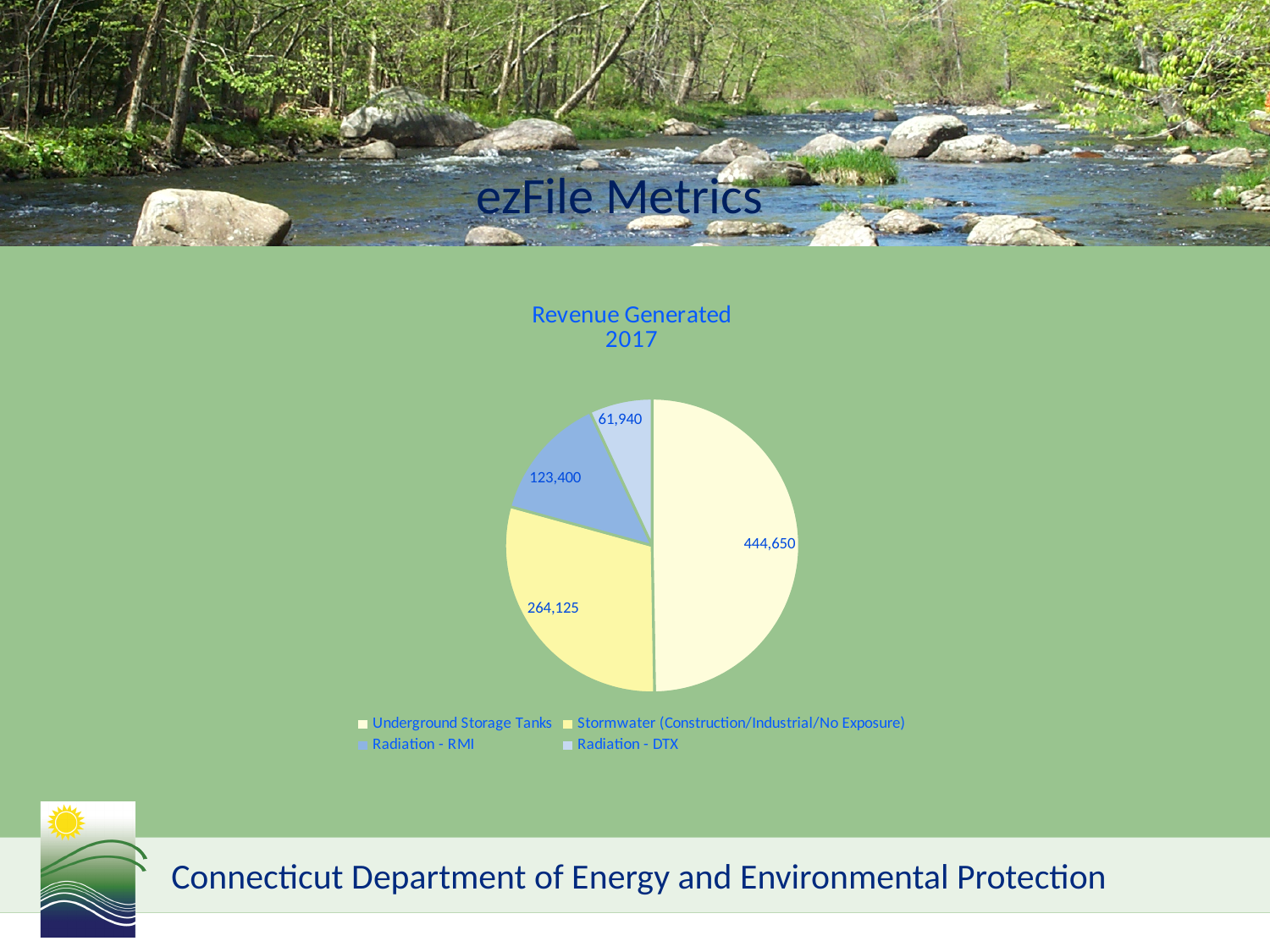
What is the revenue value for Radiation - RMI? 123,400 Which category generated the most revenue? Underground Storage Tanks What is the difference between the revenue for Underground Storage Tanks and Stormwater (Construction/Industrial/No Exposure)? 180,525 What is the revenue value for Underground Storage Tanks? 444,650 Which category generated the least revenue? Radiation - DTX What is the revenue value for Radiation - DTX? 61,940 What type of chart is shown on the slide? Pie chart Which generated more revenue, Radiation - RMI or Radiation - DTX? Radiation - RMI What is the title of the chart? Revenue Generated 2017 How many slices does the pie chart have? 4 What is the revenue value for Stormwater (Construction/Industrial/No Exposure)? 264,125 What is the total revenue across all four slices of the pie? 894,115